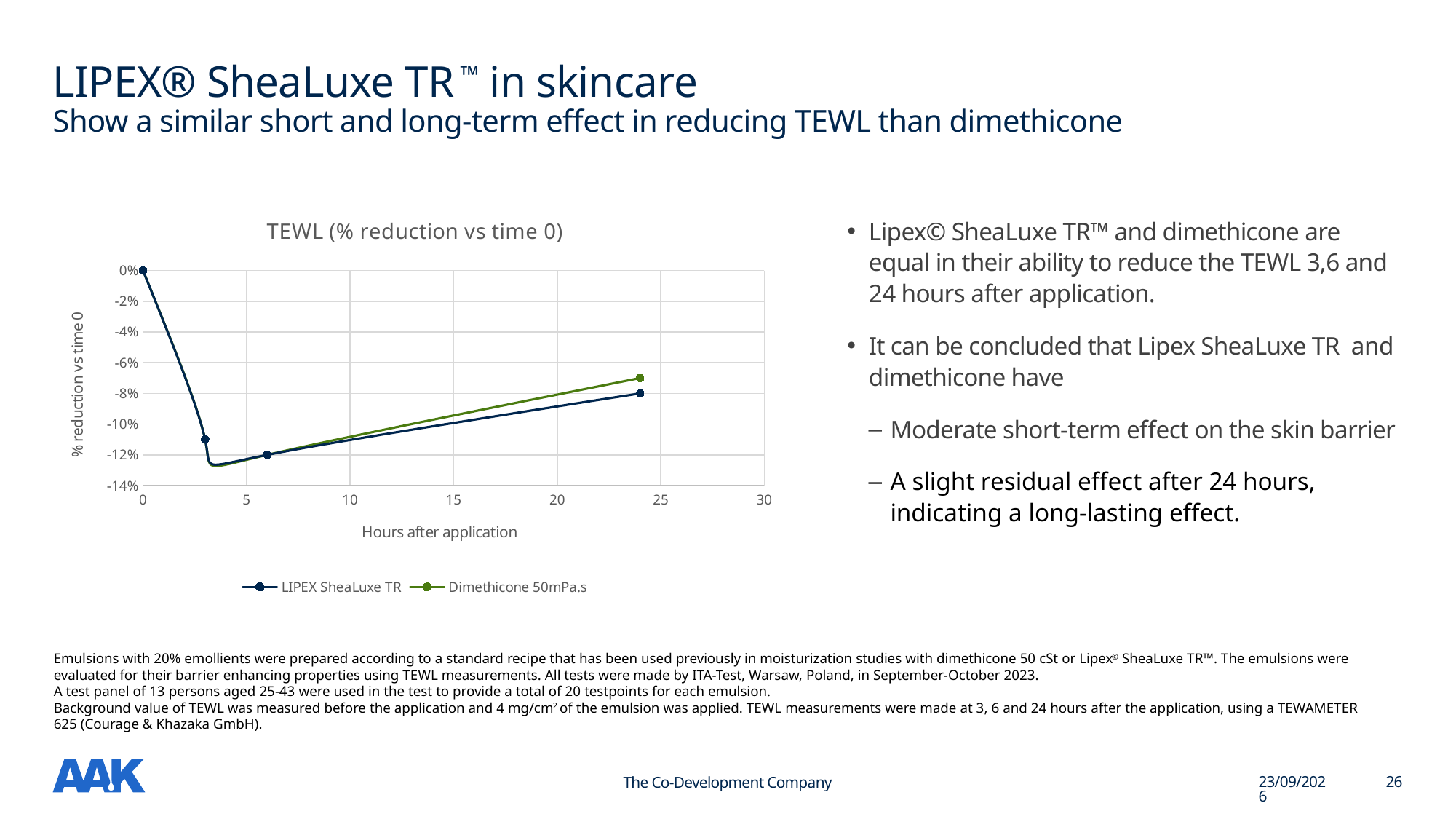
Between 6 and 24 hours after application, do the values of both series rise or fall? Rise How many series does the chart legend list? 2 What is the title of the chart? TEWL (% reduction vs time 0) What is the value of the LIPEX SheaLuxe TR series at 0 hours after application? 0% What type of chart is shown on the slide? Line chart At which hour after application does the LIPEX SheaLuxe TR series reach its lowest plotted point? 6 What is the value of the LIPEX SheaLuxe TR series at 6 hours after application? -12% What is the label of the x axis of the chart? Hours after application At 24 hours after application, which series has the lower (more negative) value: LIPEX SheaLuxe TR or Dimethicone 50mPa.s? LIPEX SheaLuxe TR What is the value of the LIPEX SheaLuxe TR series at 24 hours after application? -8% Is the value for Dimethicone 50mPa.s at 3 hours after application greater or less than -10%? less How many data points are plotted for the LIPEX SheaLuxe TR series? 4